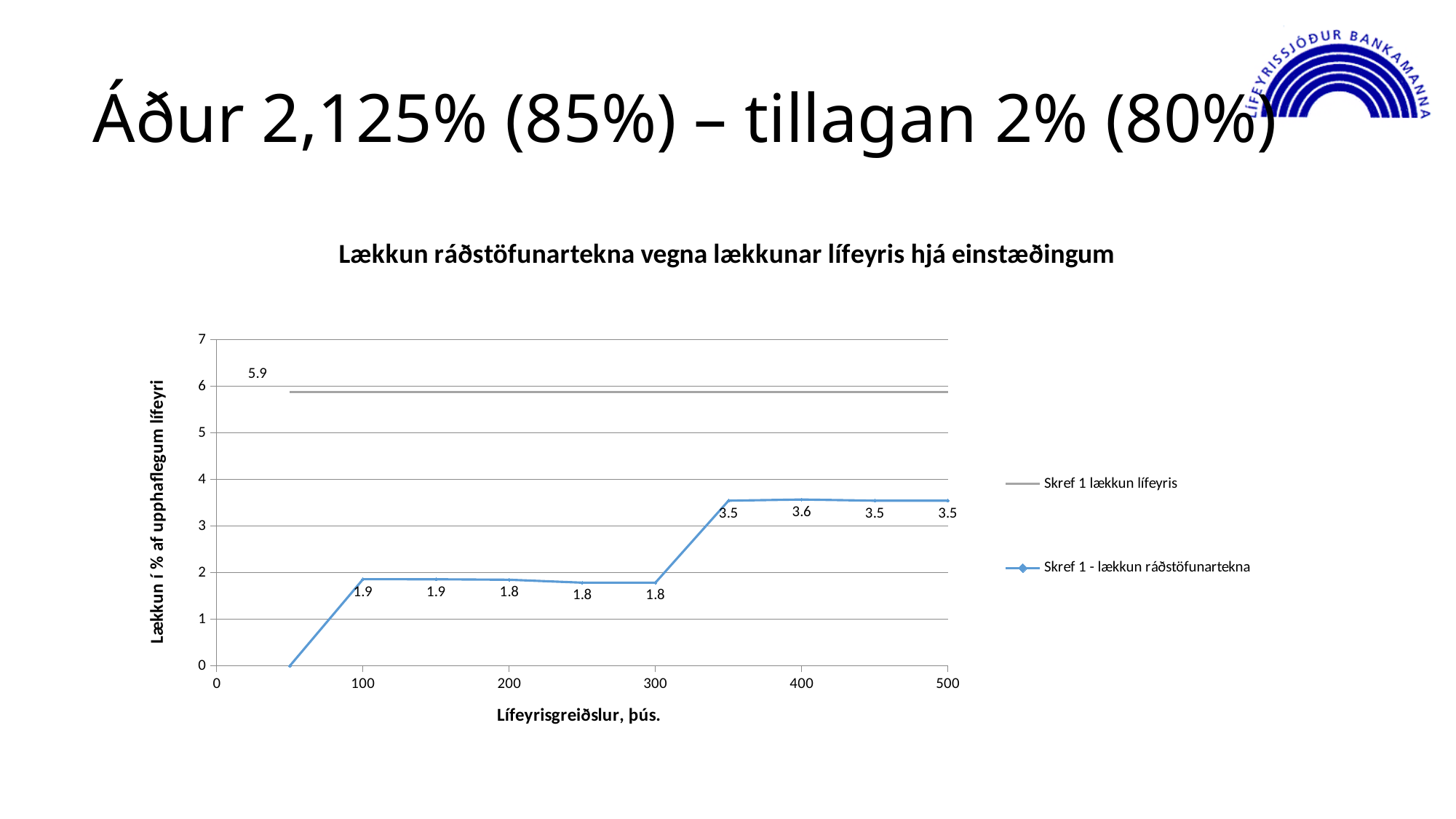
What is the value of the 'Skref 1 - lækkun ráðstöfunartekna' series at 400 on the x axis? 3.6 Does the 'Skref 1 - lækkun ráðstöfunartekna' series rise or fall between 300 and 350 on the x axis? rise Which is larger: the 'Skref 1 - lækkun ráðstöfunartekna' value at 350 or at 200? 350 What is the title of the chart? Lækkun ráðstöfunartekna vegna lækkunar lífeyris hjá einstæðingum What value is labelled for the 'Skref 1 lækkun lífeyris' series? 5.9 What kind of chart is shown on the slide? line chart Is the value of 'Skref 1 - lækkun ráðstöfunartekna' at 500 greater or less than 4? less What is the label of the x axis? Lífeyrisgreiðslur, þús. How many series does the legend list? 2 What is the value of the 'Skref 1 - lækkun ráðstöfunartekna' series at 100 on the x axis? 1.9 What is the difference between the 'Skref 1 - lækkun ráðstöfunartekna' values at 400 and at 300? 1.8 What is the value of the 'Skref 1 - lækkun ráðstöfunartekna' series at 300 on the x axis? 1.8